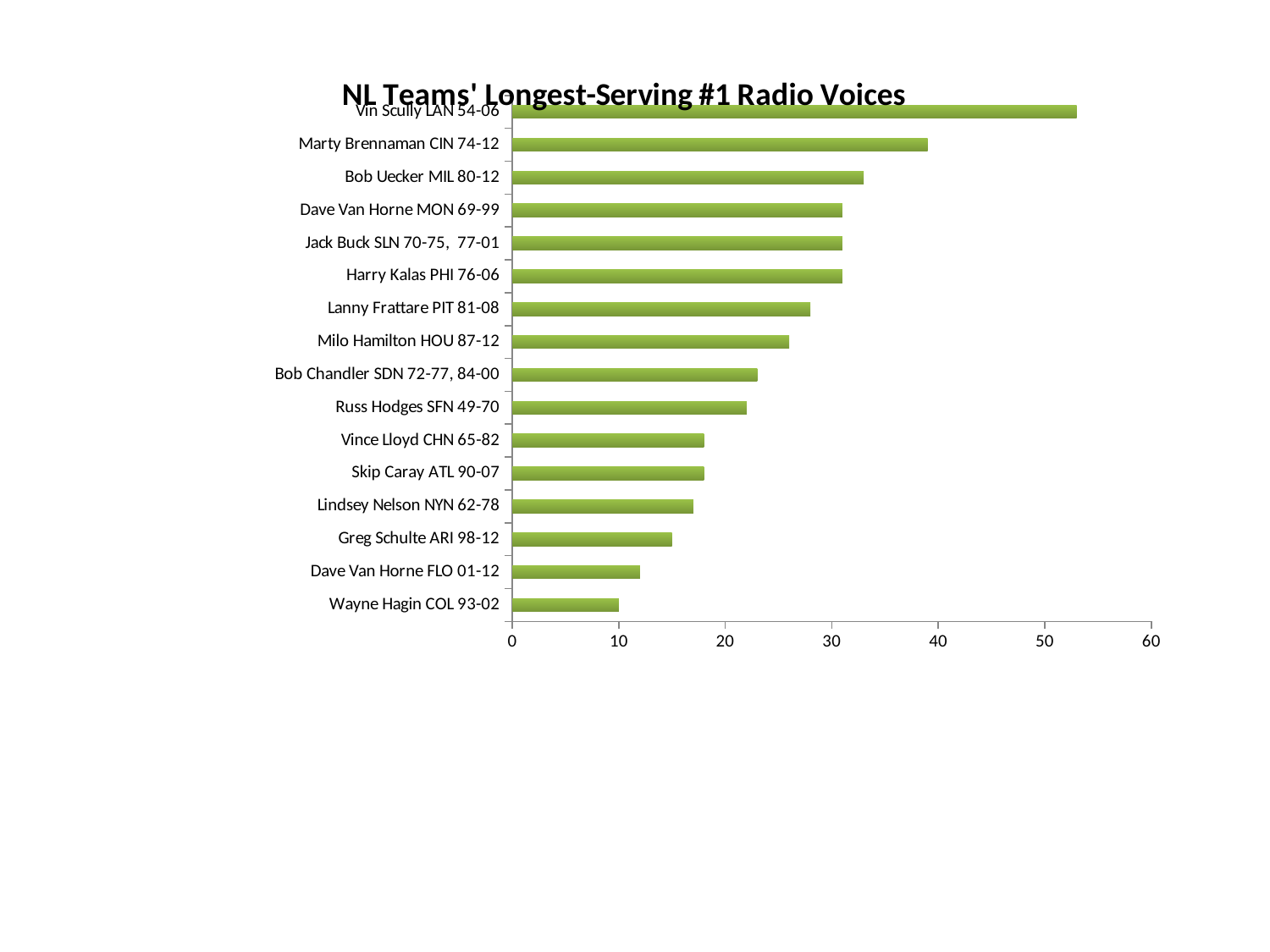
Which has the larger value, Lanny Frattare PIT 81-08 or Russ Hodges SFN 49-70? Lanny Frattare PIT 81-08 Is the value for Bob Uecker MIL 80-12 greater or less than 30? greater What is the title of the chart? NL Teams' Longest-Serving #1 Radio Voices Is the value for Milo Hamilton HOU 87-12 greater or less than 20? greater Is the value for Marty Brennaman CIN 74-12 greater or less than 40? less Which radio voice has the longest bar in the chart? Vin Scully LAN 54-06 Which has the larger value, Dave Van Horne FLO 01-12 or Lindsey Nelson NYN 62-78? Lindsey Nelson NYN 62-78 Which radio voice has the shortest bar in the chart? Wayne Hagin COL 93-02 How many radio voices (categories) are plotted in the chart? 16 What kind of chart is shown on the slide? bar chart